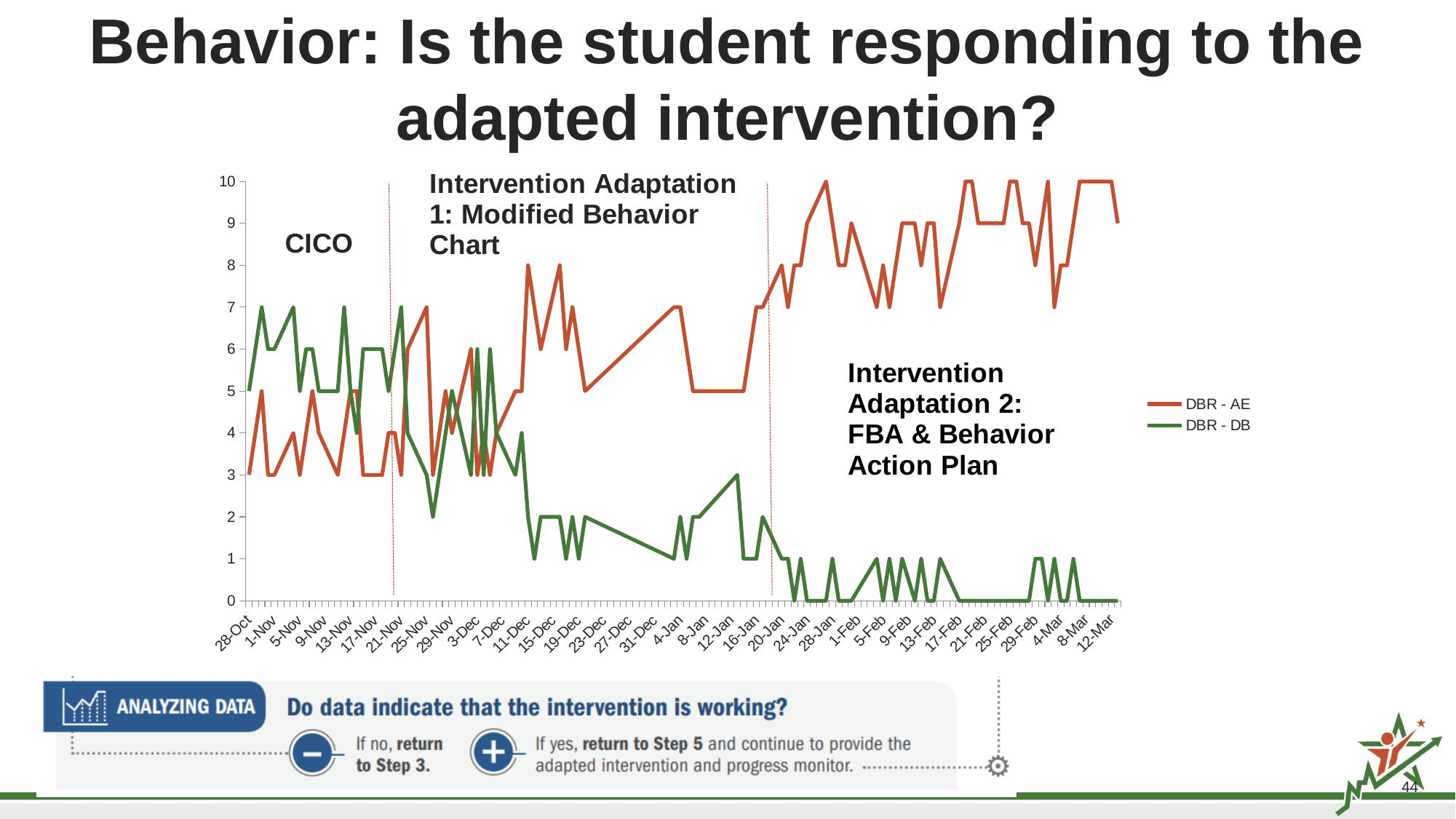
Is the DBR - DB value on 12-Mar greater or less than 5? less Which colour is used for the DBR - DB series? green What is the DBR - AE value on 28-Oct? 3 Does the DBR - AE series generally rise or fall from 28-Oct to 12-Mar? rise What is the DBR - AE value on 12-Mar? 10 What is the DBR - DB value on 28-Oct? 5 What is the lowest value reached by the DBR - DB series? 0 What kind of chart is shown on the slide? line chart What are the two series named in the legend? DBR - AE and DBR - DB What is the highest value reached by the DBR - AE series? 10 Which series has the higher value on 12-Mar, DBR - AE or DBR - DB? DBR - AE How many series does the legend list? 2